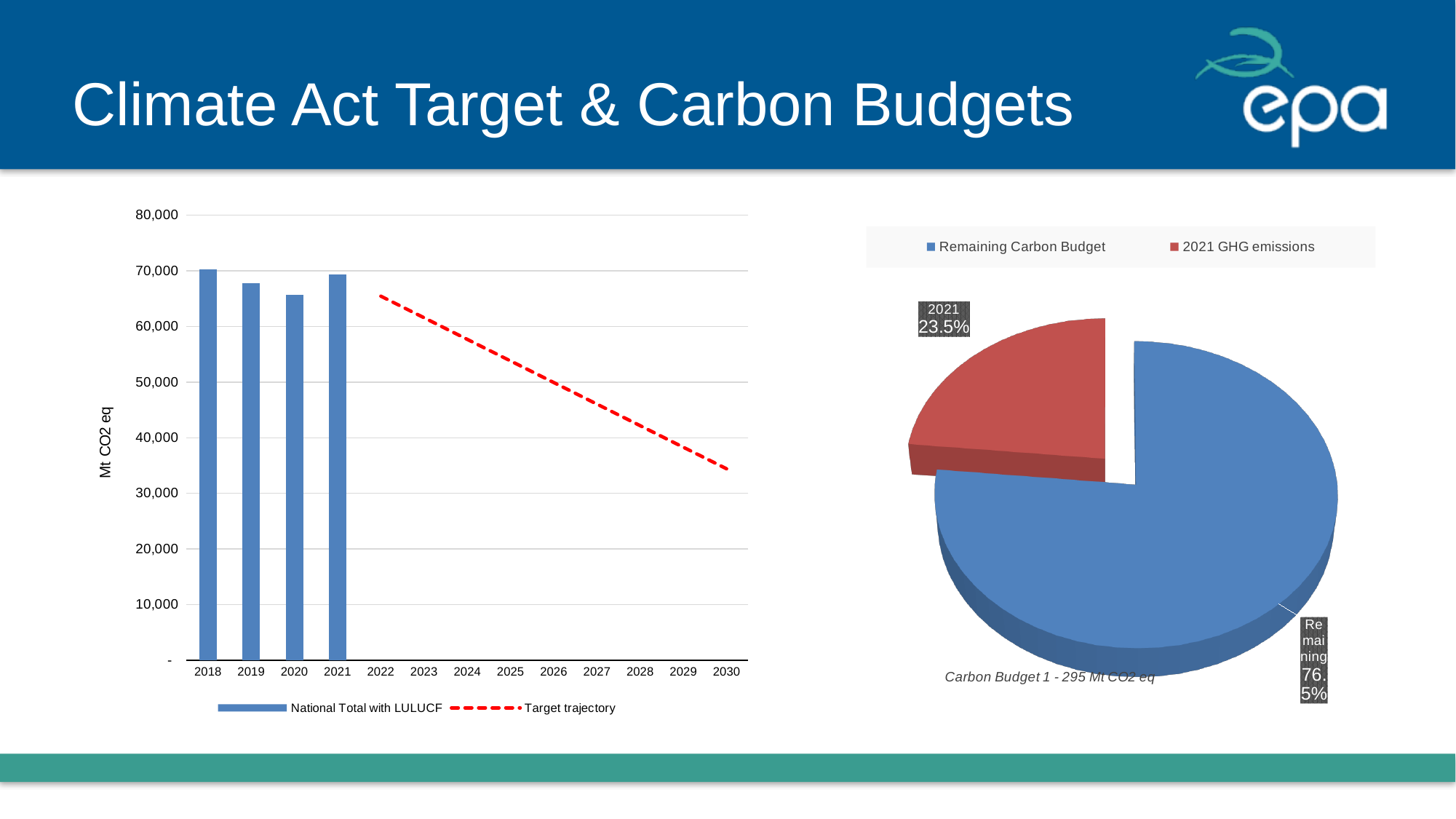
In the left chart, is the National Total with LULUCF for 2020 greater or less than 70,000? less In the right pie chart, what is the difference in percentage points between the Remaining Carbon Budget share and the 2021 GHG emissions share? 53 In the left chart, is the National Total with LULUCF for 2021 greater or less than 60,000? greater In the left chart, which year has the larger National Total with LULUCF bar, 2019 or 2020? 2019 In the left chart, how many years have a bar plotted for National Total with LULUCF? 4 In the left chart, is the Target trajectory value for 2030 greater or less than 40,000? less In the right pie chart, what share is labelled for Remaining Carbon Budget? 76.5% In the right pie chart, what share is labelled for 2021 GHG emissions? 23.5% In the left chart, does the Target trajectory rise or fall from 2022 to 2030? fall In the left chart, how many series does the legend list? 2 In the left chart, which year has the lowest National Total with LULUCF bar? 2020 In the left chart, what does the y-axis label say? Mt CO2 eq